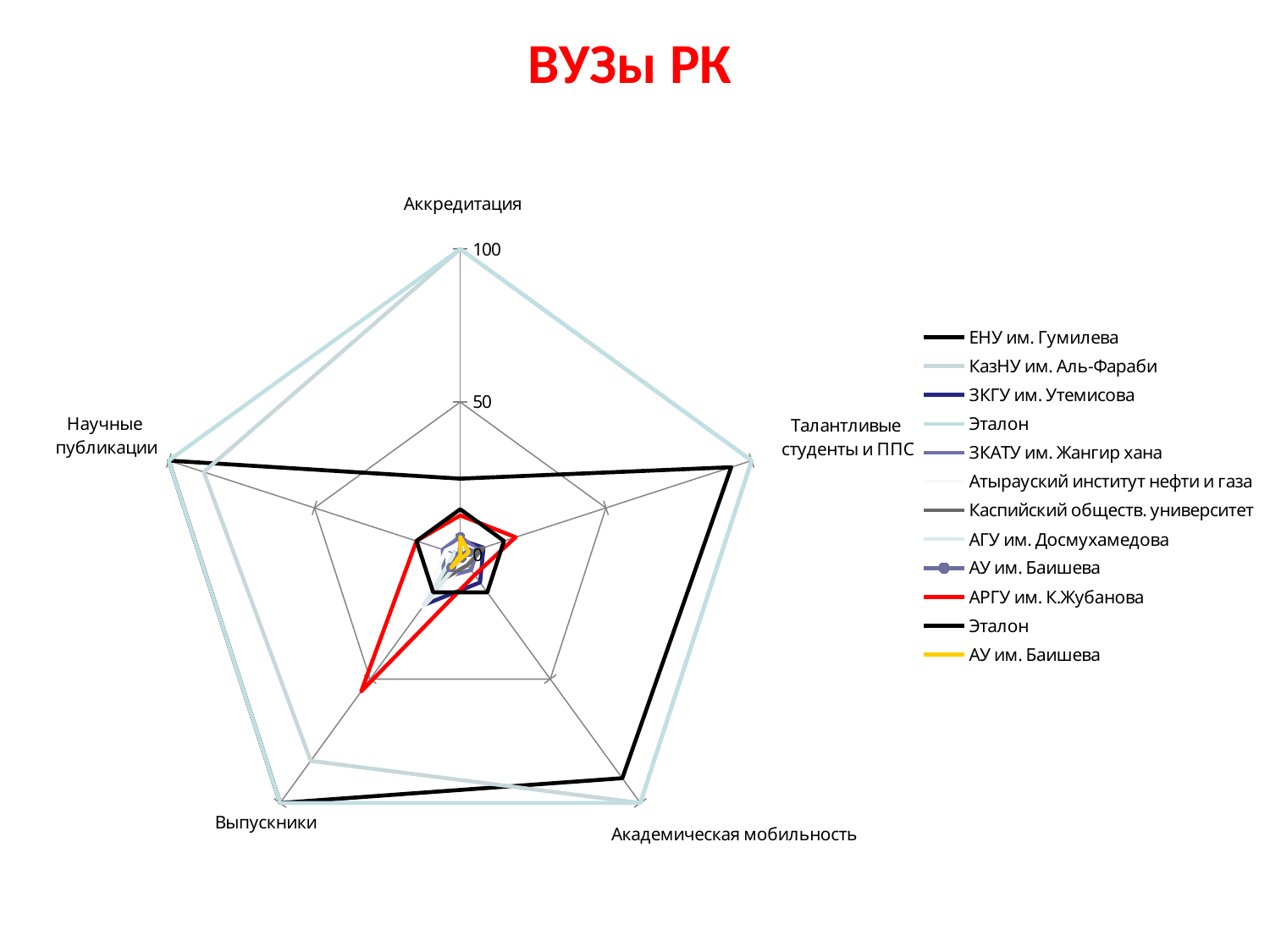
Is the value for Выпускники for АРГУ им. К.Жубанова greater or less than 50? greater How many series does the legend list? 12 What is the maximum value shown on the radar chart's axis scale? 100 How many axes (categories) does the radar chart have? 5 Is the value for Академическая мобильность for АРГУ им. К.Жубанова greater or less than 50? less Is the value for Талантливые студенты и ППС for АРГУ им. К.Жубанова greater or less than 50? less What kind of chart is shown on the slide? radar chart For АРГУ им. К.Жубанова, which category has the highest value? Выпускники What is the title of the chart? ВУЗы РК Which category is at the top of the radar chart? Аккредитация For АРГУ им. К.Жубанова, which category has the higher value: Выпускники or Аккредитация? Выпускники